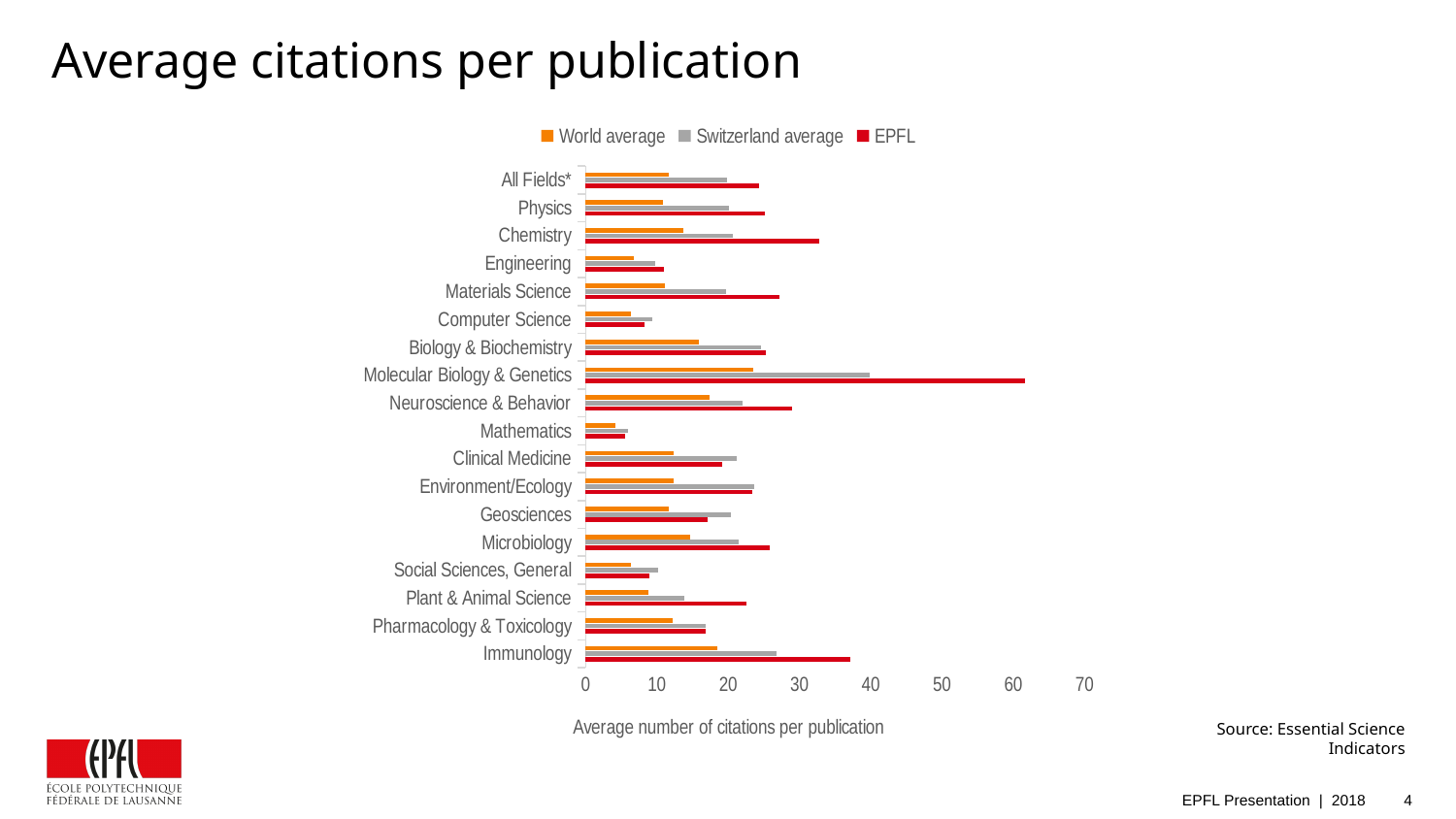
Is the EPFL value for Molecular Biology & Genetics greater or less than 50? greater Is the EPFL value for Mathematics greater or less than 10? less Is the EPFL value for Chemistry greater or less than 30? greater How many fields (categories) are plotted on the chart? 18 How many series does the legend list? 3 For Geosciences, which is larger: the Switzerland average or the EPFL value? Switzerland average Which field has the highest Switzerland average value? Molecular Biology & Genetics What kind of chart is shown on the slide? Bar chart Which field has the lowest EPFL value? Mathematics Which field has the highest EPFL value? Molecular Biology & Genetics What is the label of the horizontal axis? Average number of citations per publication